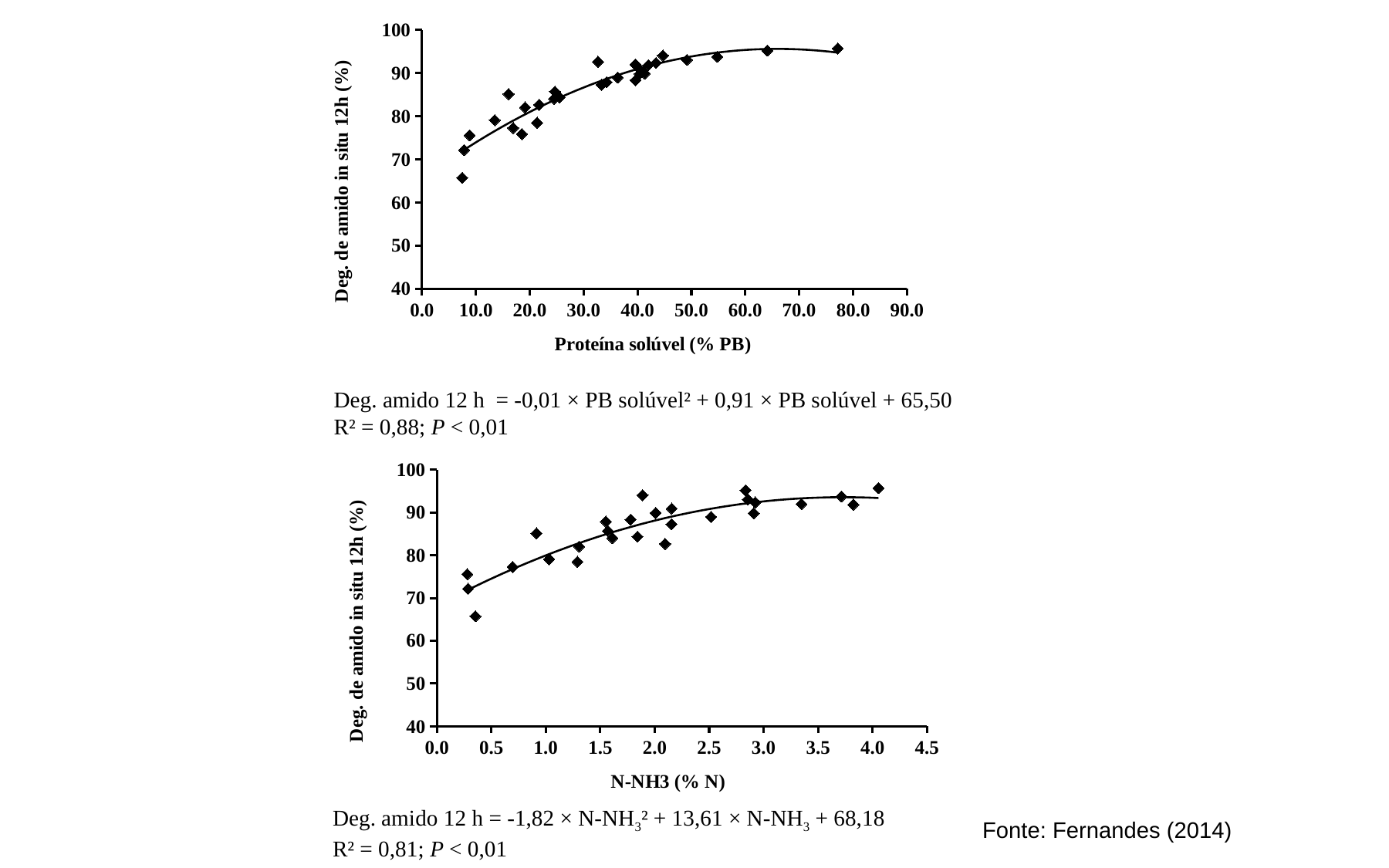
What is the x-axis label of the top chart? Proteína solúvel (% PB) In the bottom chart, do the plotted values generally rise or fall as N-NH3 (% N) increases? rise In the top chart, is the lowest plotted value greater or less than 70? less What kind of chart is the top chart on the slide? scatter chart In the top chart, do the plotted values generally rise or fall as Proteína solúvel (% PB) increases? rise In the bottom chart, is the lowest plotted value greater or less than 70? less What is the x-axis label of the bottom chart? N-NH3 (% N) What kind of chart is the bottom chart on the slide? scatter chart In the bottom chart, is the highest plotted value greater or less than 90? greater